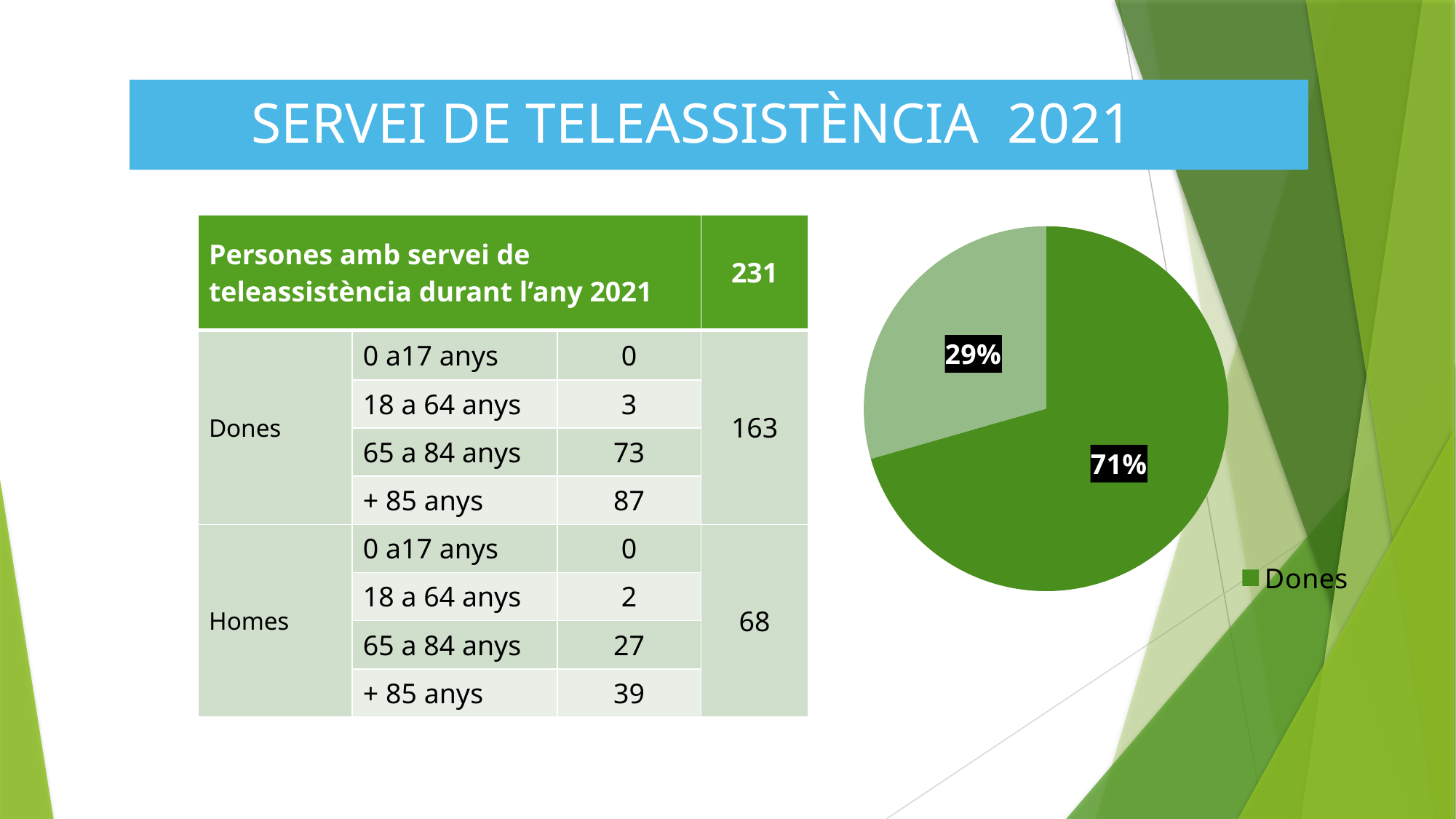
How many slices does the pie chart have? 2 What kind of chart is shown on the right of the slide? pie chart What colour is the Dones slice in the pie chart? dark green What share of the pie chart does the Dones slice represent? 71% Is the Dones slice larger or smaller than the other slice of the pie chart? larger What is the difference in percentage points between the two slices of the pie chart? 42 percentage points What percentage is printed on the lighter green slice of the pie chart? 29% Which legend entry is readable next to the pie chart? Dones Which slice of the pie chart is the largest? Dones (71%)